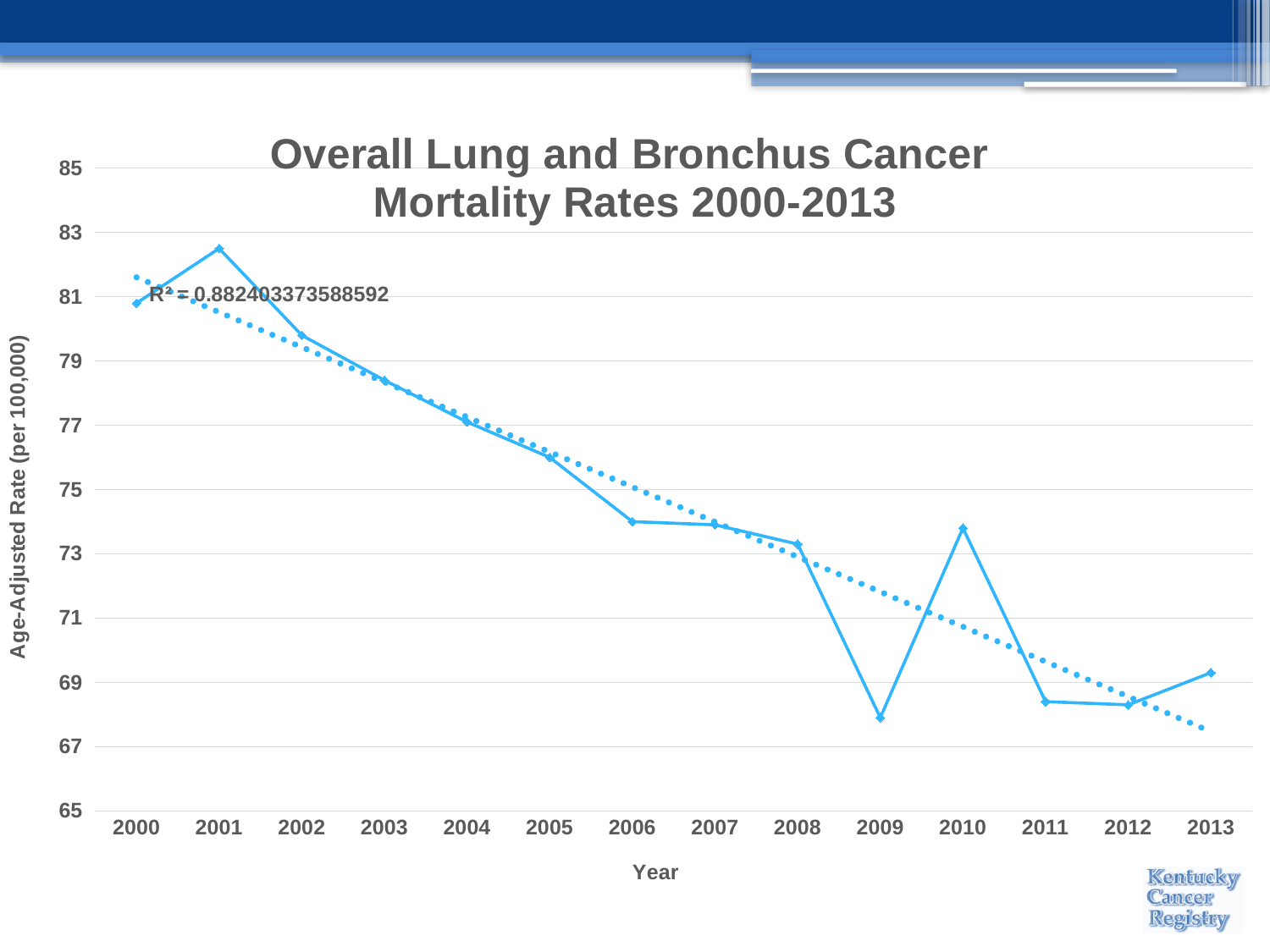
What is the title of the chart? Overall Lung and Bronchus Cancer Mortality Rates 2000-2013 Which year has the highest mortality rate? 2001 Which year has the higher mortality rate, 2010 or 2011? 2010 Do the mortality rates generally rise or fall from 2000 to 2013? fall Which year has the higher mortality rate, 2003 or 2005? 2003 What R² value is printed on the chart for the trendline? R² = 0.882403373588592 Is the mortality rate for 2001 greater or less than 81? greater Is the mortality rate for 2009 greater or less than 69? less How many years are plotted along the x axis? 14 What kind of chart is shown on the slide? line chart Is the mortality rate for 2006 greater or less than 75? less Which year has the lowest mortality rate? 2009